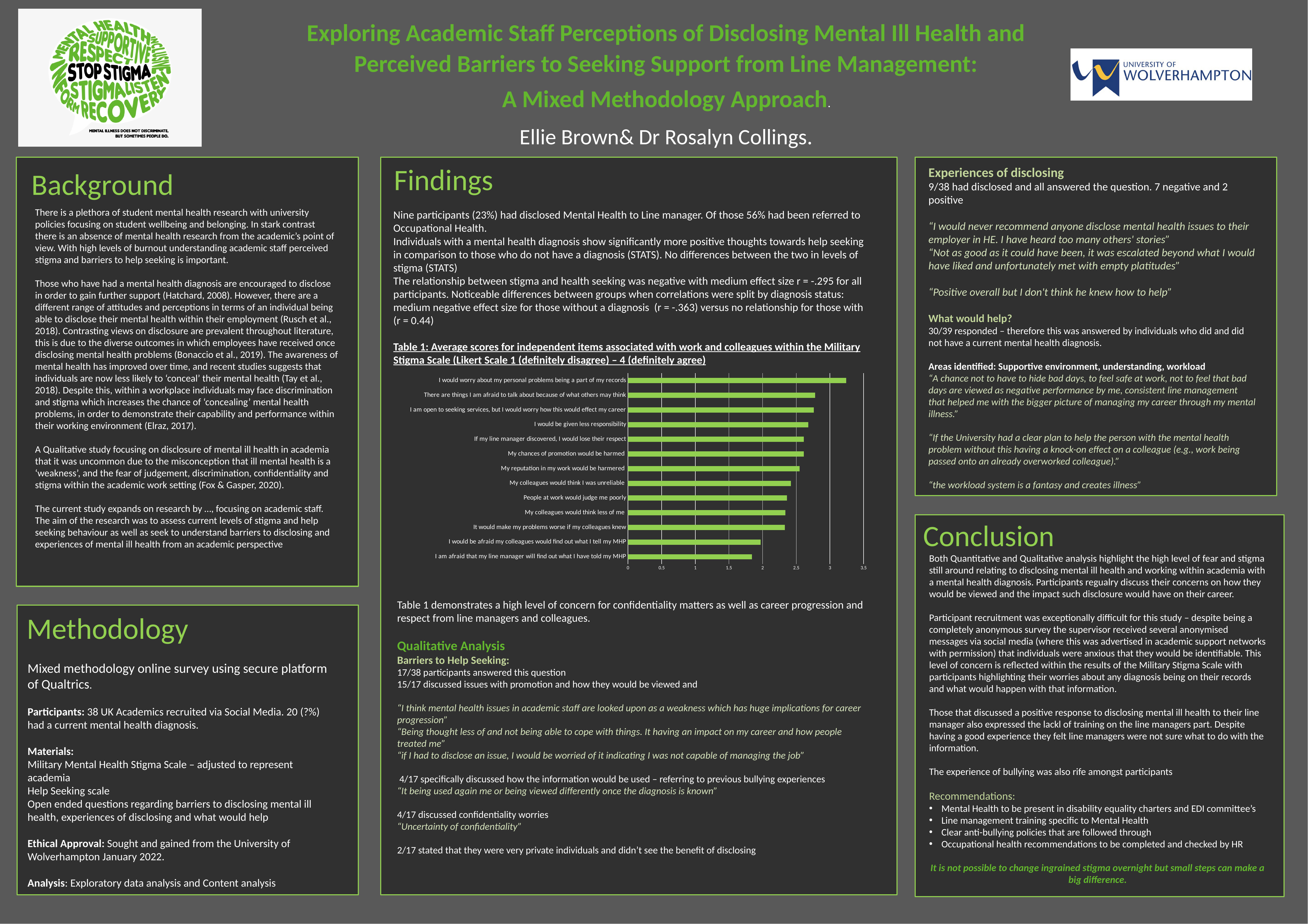
Which has the larger value: "I would be given less responsibility" or "My colleagues would think less of me"? I would be given less responsibility What kind of chart is shown under Table 1 in the Findings section? bar chart What colour are the bars in the Table 1 chart? green Which statement has the highest average score in the Table 1 chart? I would worry about my personal problems being a part of my records How many statements (bars) are plotted in the Table 1 chart? 13 Is the value for "I would worry about my personal problems being a part of my records" greater or less than 3? greater What is the highest tick value shown on the horizontal axis of the Table 1 chart? 3.5 Is the value for "There are things I am afraid to talk about because of what others may think" greater or less than 2.5? greater Which has the larger value: "I would worry about my personal problems being a part of my records" or "I am afraid that my line manager will find out what I have told my MHP"? I would worry about my personal problems being a part of my records Is the value for "I am afraid that my line manager will find out what I have told my MHP" greater or less than 2? less